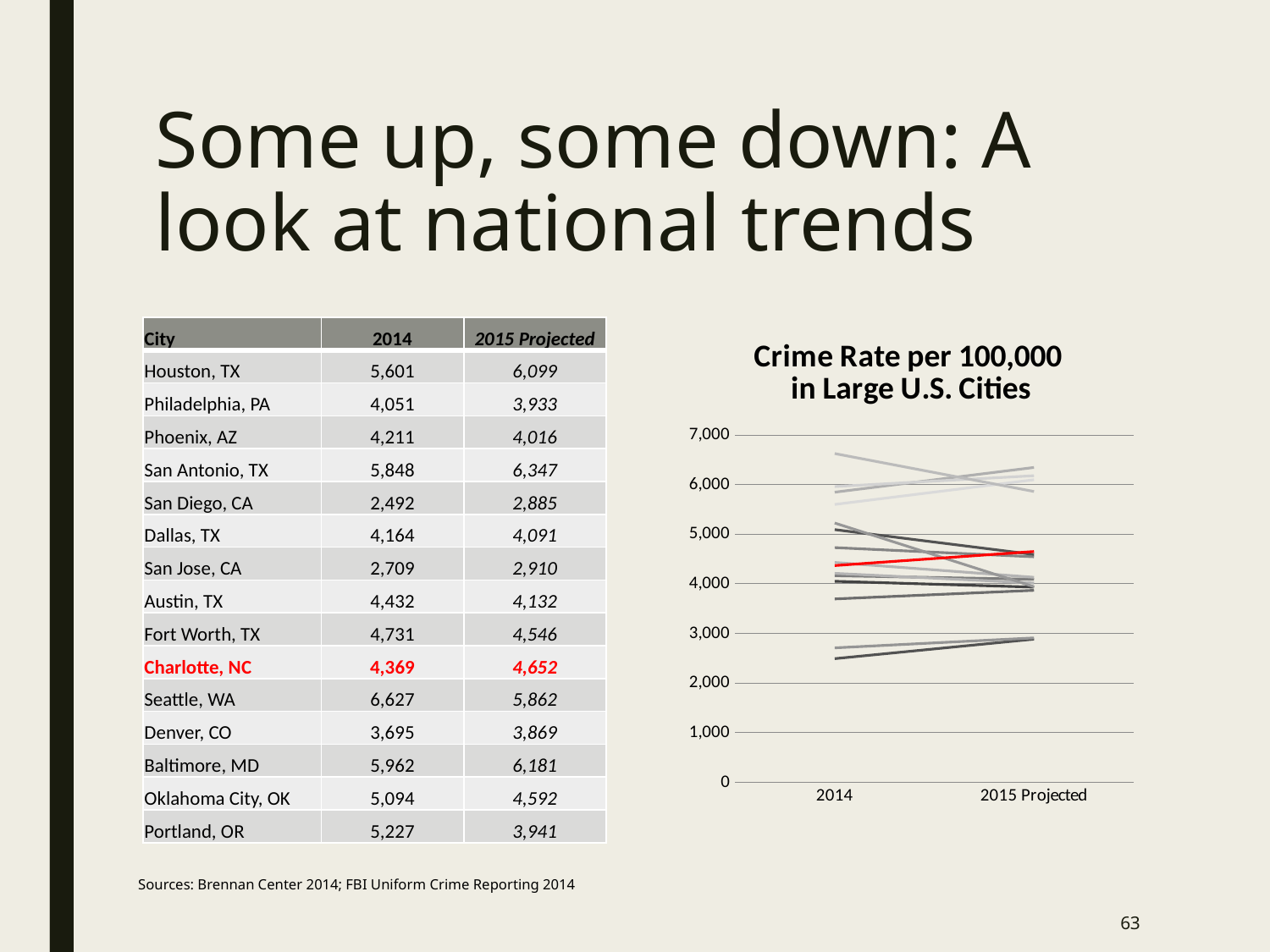
What is the 2014 value of the red line (Charlotte, NC) in the chart? 4,369 What is the lowest 2014 value plotted in the chart? 2,492 What is the title of the chart? Crime Rate per 100,000 in Large U.S. Cities How many points are shown along the x axis of the chart? 2 Which city does the red line in the chart represent? Charlotte, NC What kind of chart is shown on the slide? line chart What is the highest 2014 value plotted in the chart? 6,627 Is the 2015 Projected value of the red line in the chart greater or less than 5,000? less Is the 2014 value of the red line in the chart greater or less than 4,000? greater By how much does the red line (Charlotte, NC) increase from 2014 to 2015 Projected? 283 What is the 2015 Projected value of the red line (Charlotte, NC) in the chart? 4,652 Does the red line in the chart rise or fall from 2014 to 2015 Projected? rises